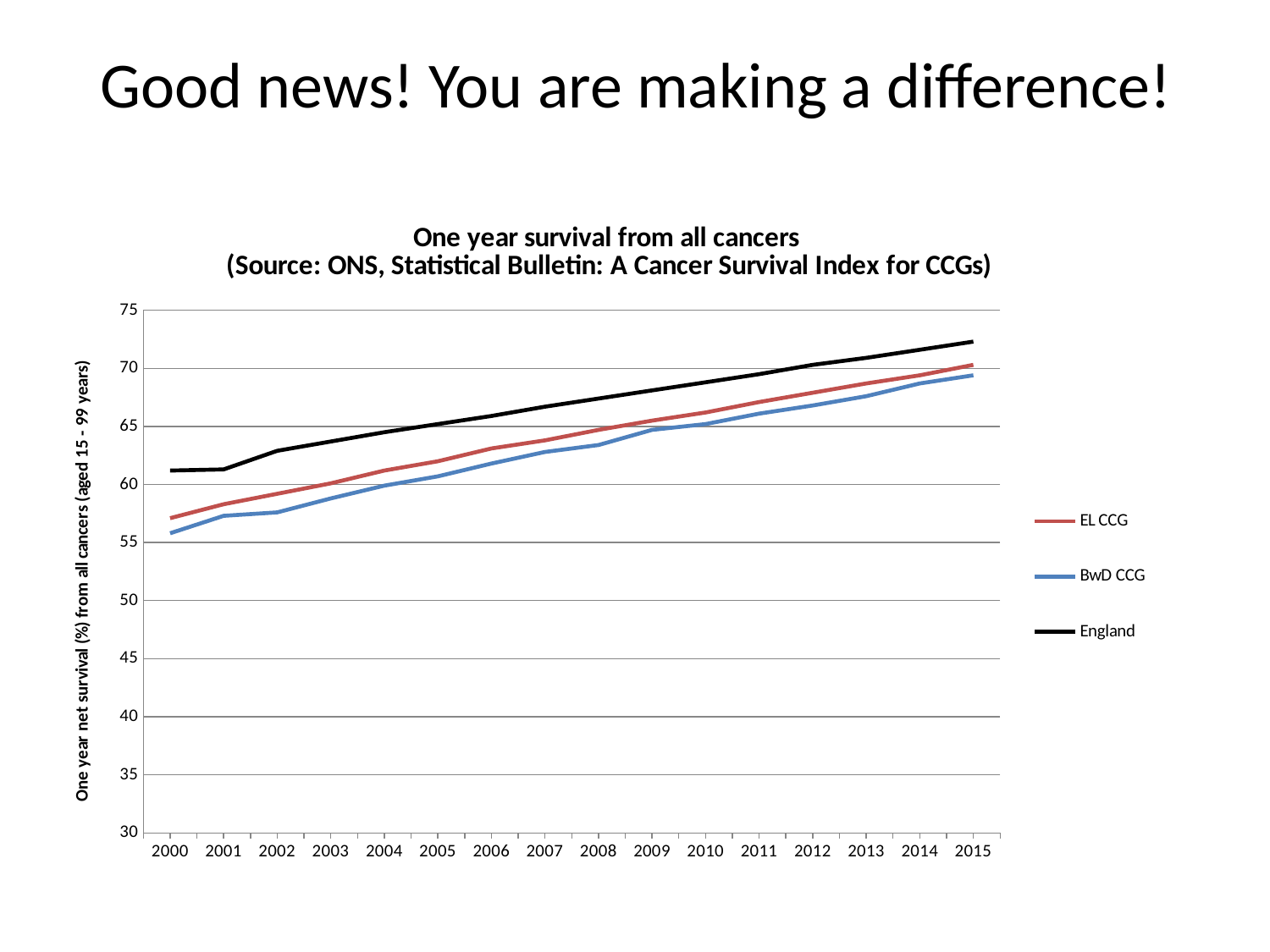
Is the value for England in 2000 greater or less than 60? greater Is the value for BwD CCG in 2015 greater or less than 70? less Is the value for BwD CCG in 2008 greater or less than 65? less Does the England line rise or fall from 2000 to 2015? rise What is the title of the chart? One year survival from all cancers (Source: ONS, Statistical Bulletin: A Cancer Survival Index for CCGs) What kind of chart is shown on the slide? line chart How many series does the legend list? 3 How many years are shown along the x axis? 16 What colour is the England line? black Which is larger in 2010, the value for England or the value for BwD CCG? England Which series has the lowest value in 2000? BwD CCG Which series has the highest value in 2015? England